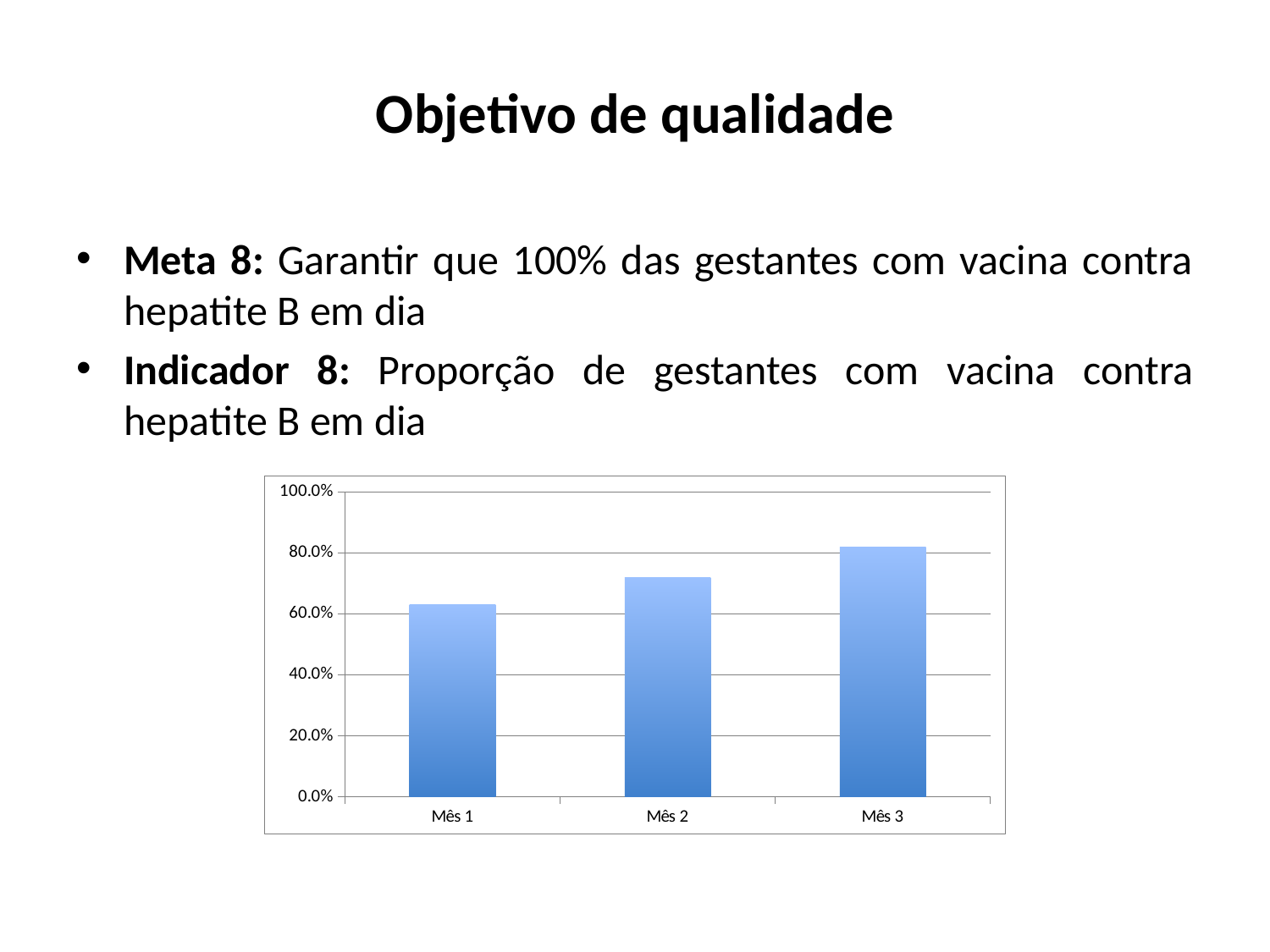
Is the value for Mês 1 greater or less than 80.0%? less Do the values in the chart rise or fall from Mês 1 to Mês 3? rise What kind of chart is shown on the slide? bar chart Which is larger in the chart, the value for Mês 1 or the value for Mês 2? Mês 2 Is the value for Mês 2 greater or less than 80.0%? less What is the highest value shown on the y axis of the chart? 100.0% Which month has the lowest bar in the chart? Mês 1 Which is larger in the chart, the value for Mês 2 or the value for Mês 3? Mês 3 Which month has the highest bar in the chart? Mês 3 How many categories are plotted on the x axis of the chart? 3 Is the value for Mês 3 greater or less than 100.0%? less